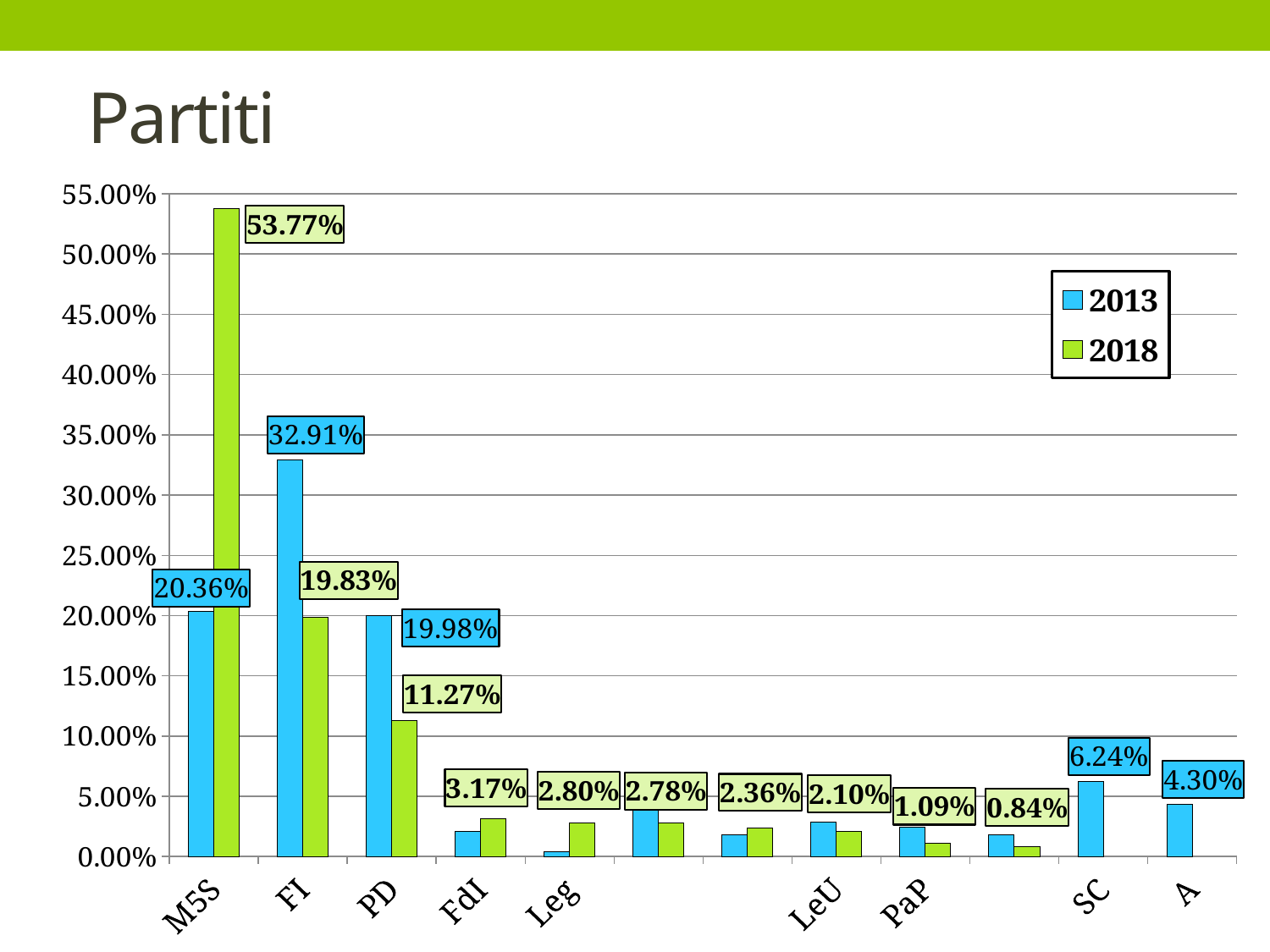
Which party has the highest value in the 2013 series? FI What is the difference between the 2018 and 2013 values for M5S? 33.41 percentage points How many series does the legend list? 2 What is the value for SC in 2013? 6.24% What is the value for PD in 2018? 11.27% What kind of chart is shown on the slide? Bar chart What is the value for FI in 2013? 32.91% What is the value for LeU in 2018? 2.10% Which party has the highest value in the 2018 series? M5S For FI, which year has the larger value, 2013 or 2018? 2013 Is the 2013 value for FdI greater or less than 5.00%? less What is the value for M5S in 2018? 53.77%